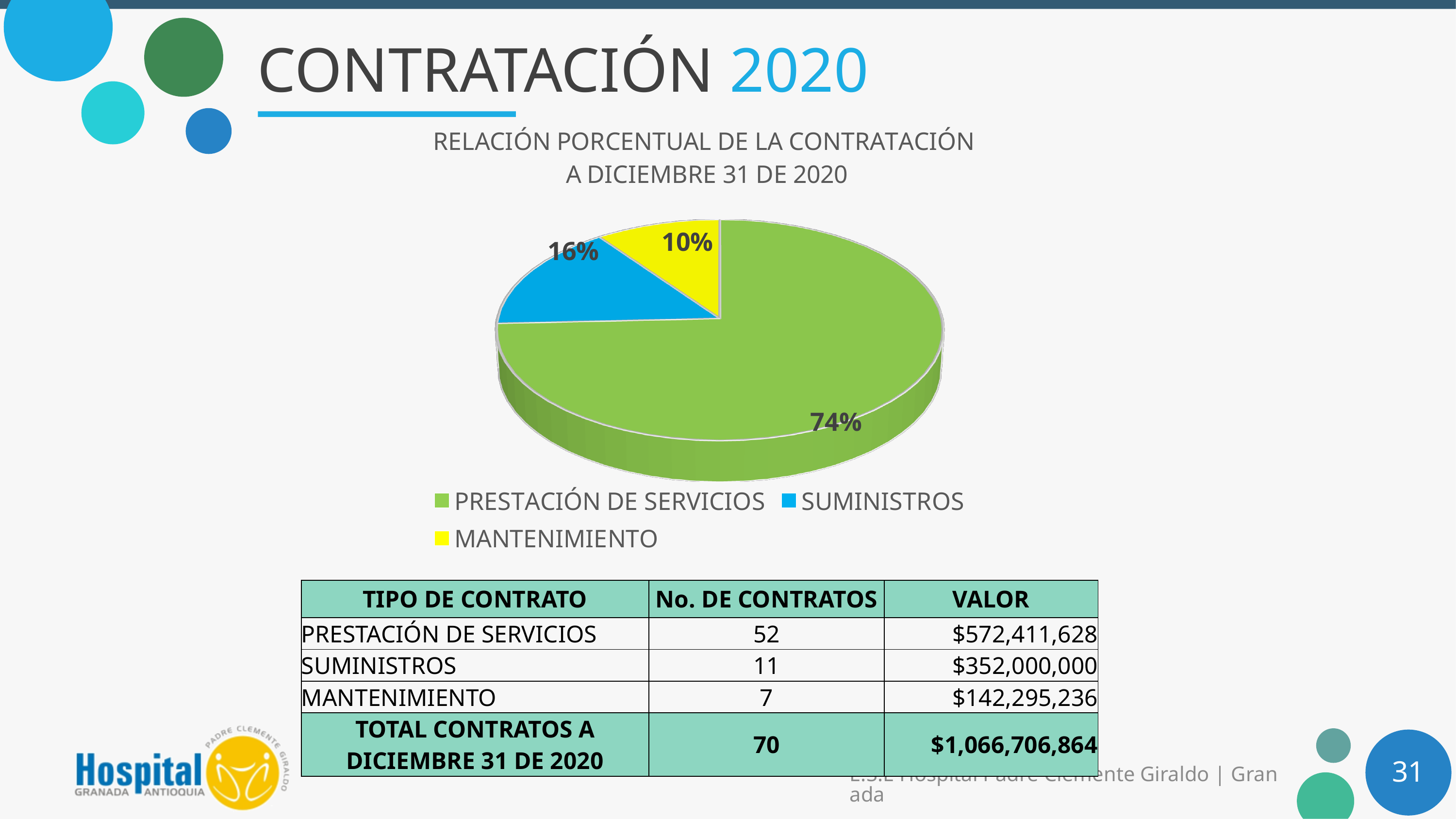
Which slice is larger, SUMINISTROS or MANTENIMIENTO? SUMINISTROS Which category has the smallest slice of the pie? MANTENIMIENTO What share of the pie does PRESTACIÓN DE SERVICIOS represent? 74% What colour is the SUMINISTROS slice in the pie chart? blue How many categories does the pie chart show? 3 What kind of chart is shown on the slide? pie chart What share of the pie does MANTENIMIENTO represent? 10% What share of the pie does SUMINISTROS represent? 16% How many entries does the legend list? 3 Which category has the largest slice of the pie? PRESTACIÓN DE SERVICIOS What is the title of the pie chart? RELACIÓN PORCENTUAL DE LA CONTRATACIÓN A DICIEMBRE 31 DE 2020 What is the difference in percentage points between the PRESTACIÓN DE SERVICIOS slice and the SUMINISTROS slice? 58